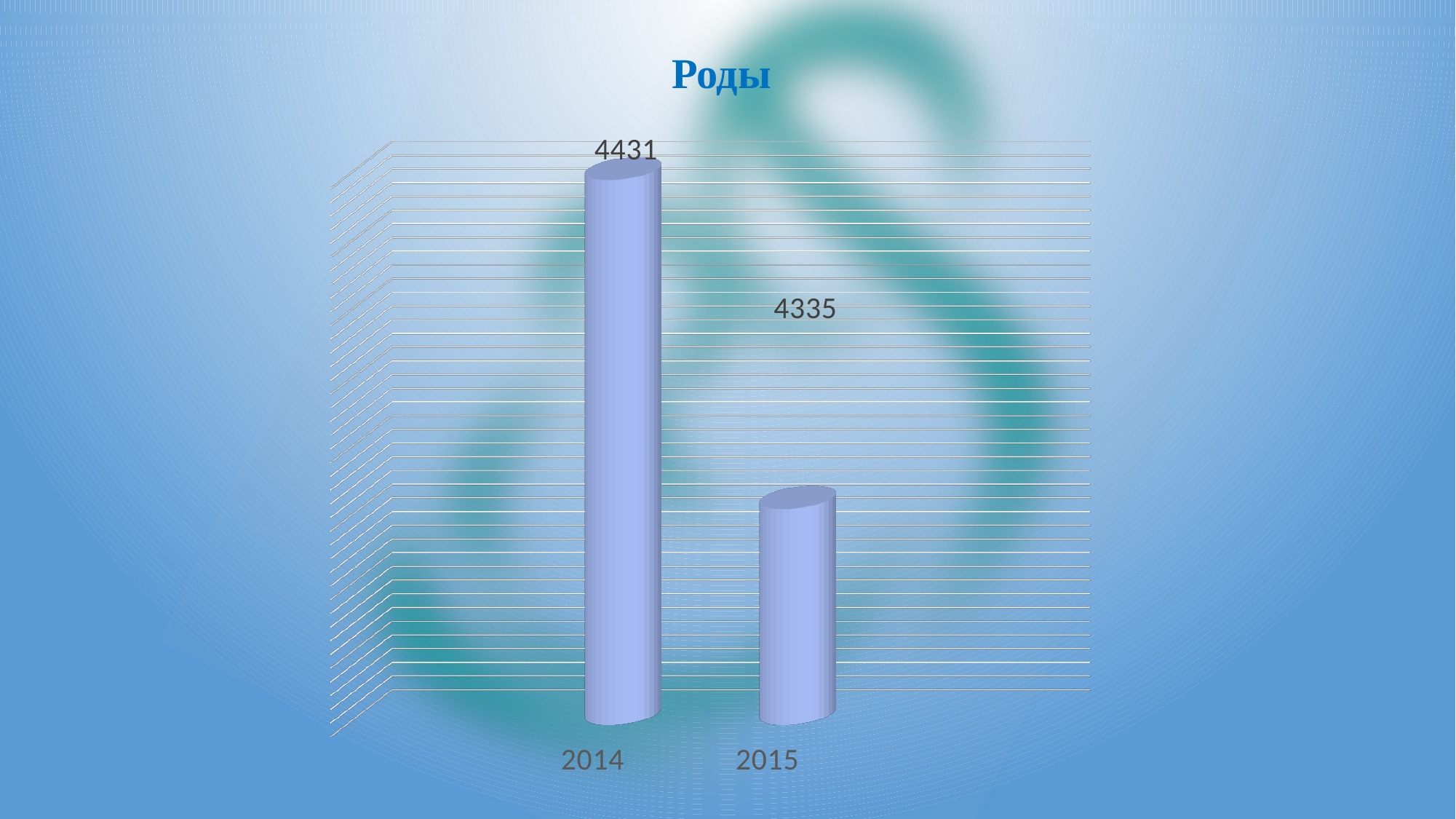
Do the values rise or fall from 2014 to 2015? fall What is the value for 2015? 4335 Which is larger, the value for 2014 or the value for 2015? 2014 What is the difference between the values for 2014 and 2015? 96 What is the value for 2014? 4431 What is the total of the values for 2014 and 2015? 8766 How many categories are shown in the chart? 2 What kind of chart is shown on the slide? bar chart Which year has the lowest value? 2015 What is the title of the chart? Роды Which year has the highest value? 2014